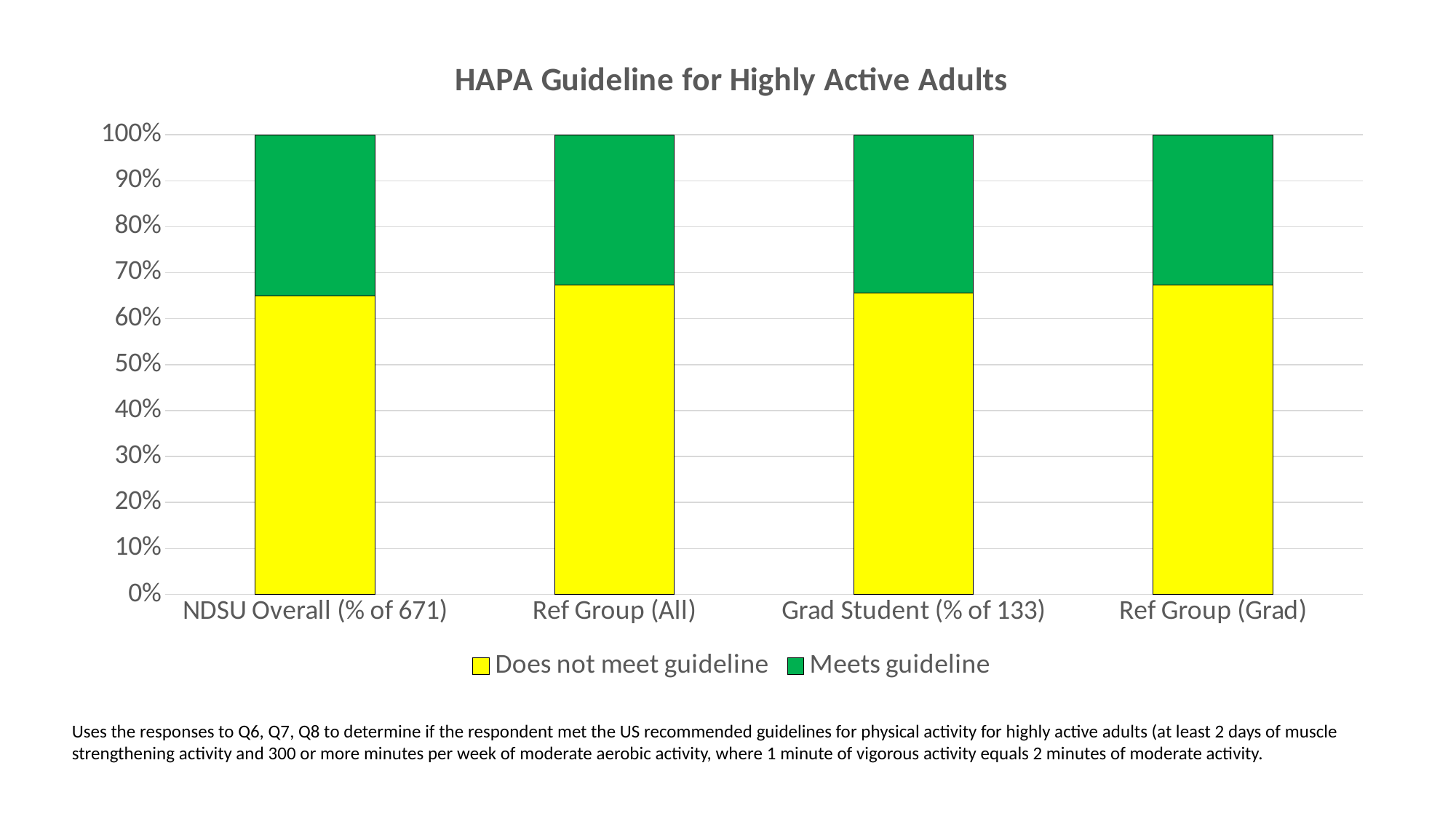
Is the 'Does not meet guideline' value for NDSU Overall (% of 671) greater or less than 60%? greater How many categories are shown on the x axis of the chart? 4 Is the 'Does not meet guideline' value for Grad Student (% of 133) greater or less than 50%? greater What type of chart is shown on the slide? Stacked bar chart How many series does the legend list? 2 Is the 'Meets guideline' share for Ref Group (Grad) greater or less than 40%? less For Grad Student (% of 133), which segment is larger: 'Does not meet guideline' or 'Meets guideline'? Does not meet guideline What is the total height of each stacked bar in the chart? 100% Which colour represents the 'Meets guideline' series? Green What is the title of the chart? HAPA Guideline for Highly Active Adults